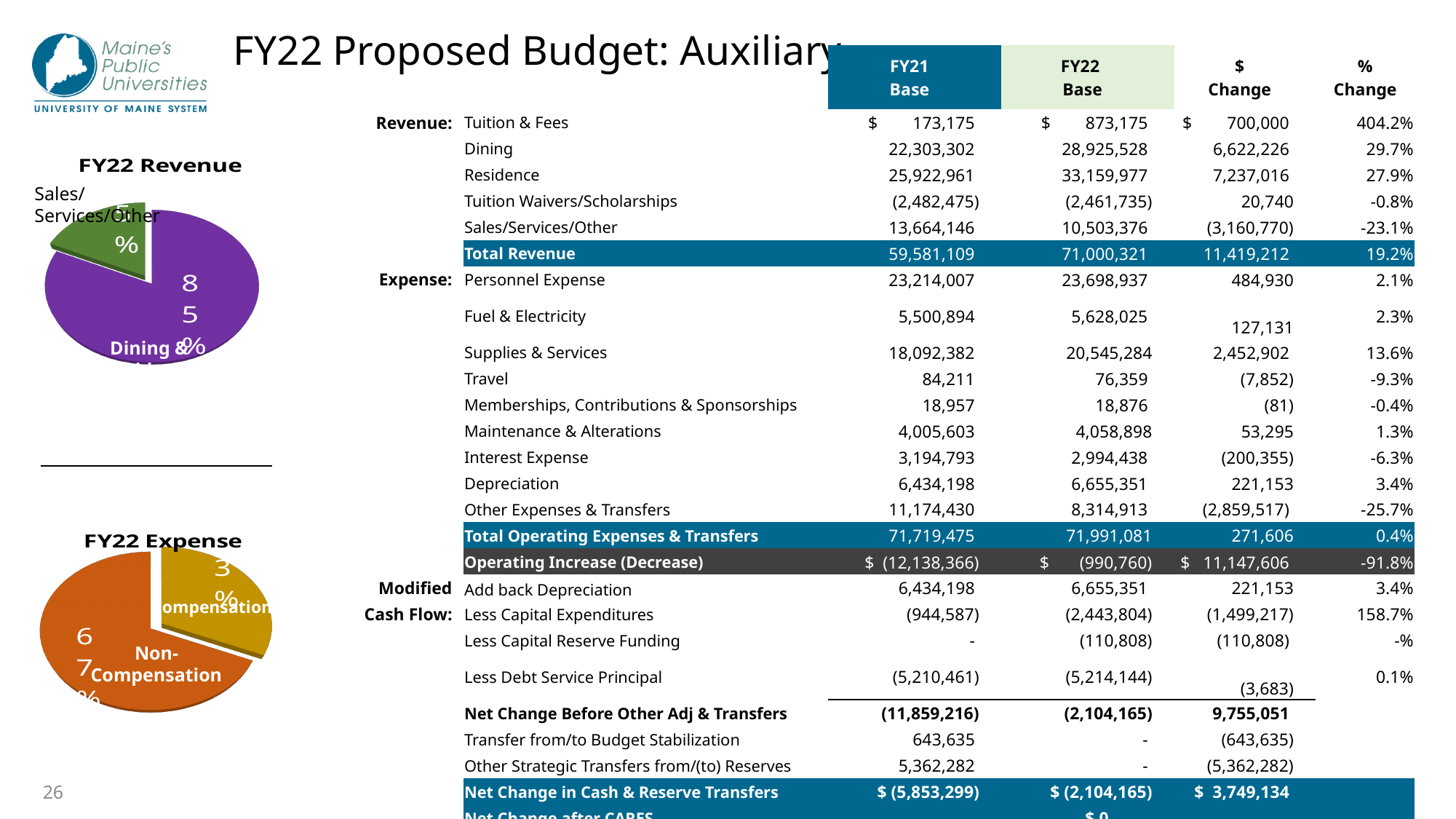
What kind of chart is the FY22 Expense chart? pie chart What is the title of the pie chart at the top left of the slide? FY22 Revenue In the FY22 Expense chart, which category has the smallest slice? Compensation In the FY22 Revenue chart, is the Sales/Services/Other slice the largest or the smallest slice? smallest In the FY22 Expense chart, what colour is the Non-Compensation slice? orange How many slices does the FY22 Revenue pie chart have? 2 What kind of chart is the FY22 Revenue chart? pie chart How many slices does the FY22 Expense pie chart have? 2 In the FY22 Expense chart, which category has the largest slice? Non-Compensation In the FY22 Expense chart, which slice is larger, Compensation or Non-Compensation? Non-Compensation